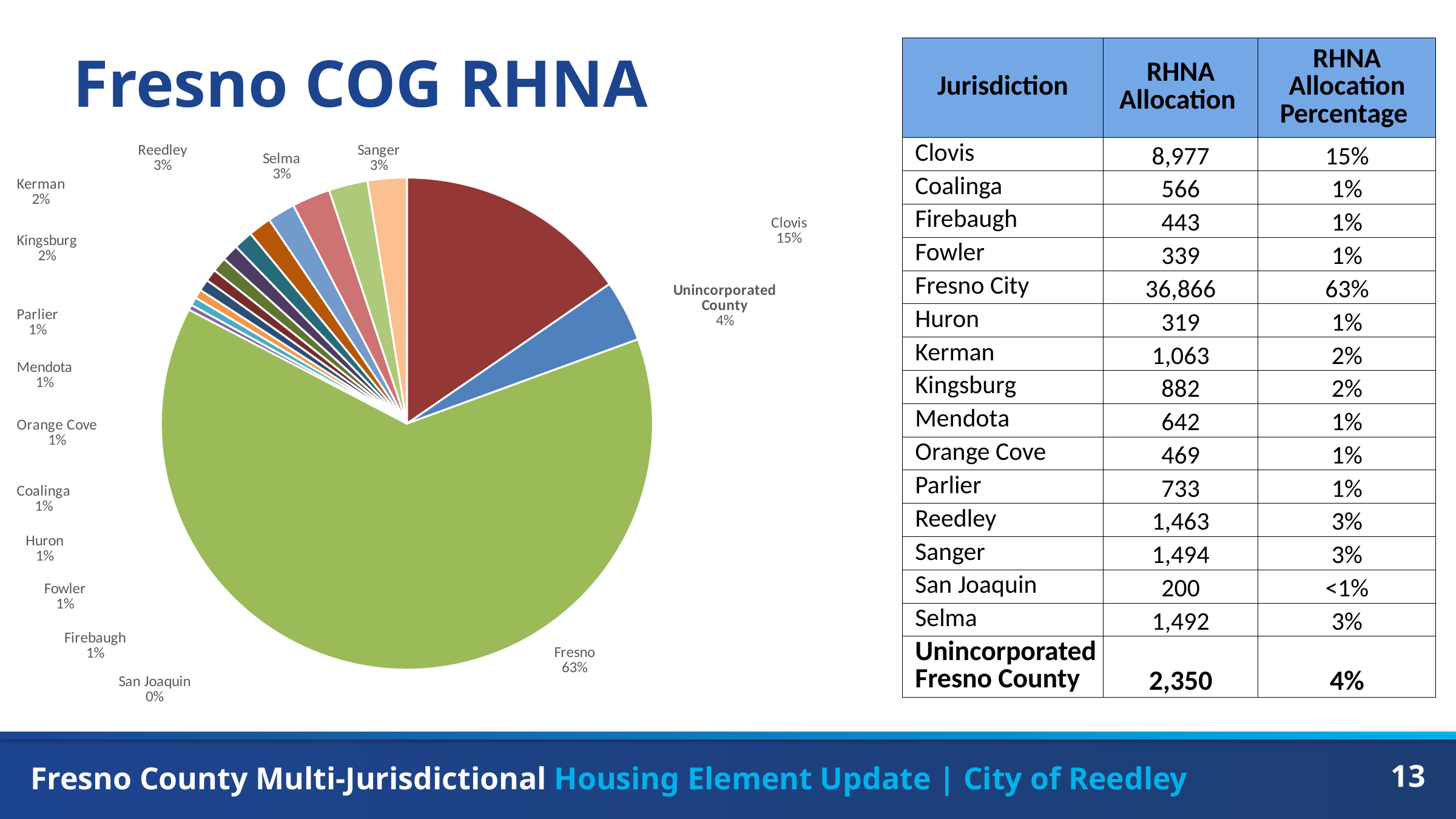
What share of the pie chart does Fresno represent? 63% How many slices does the pie chart have? 16 What is the title of the slide containing the pie chart? Fresno COG RHNA Which slice of the pie chart has the largest share? Fresno What is the difference in percentage points between Fresno and Clovis in the pie chart? 48 What share of the pie chart does Clovis represent? 15% What percentage is shown for Reedley in the pie chart? 3% Which slice of the pie chart has the smallest share? San Joaquin What kind of chart is shown on the slide? pie chart What percentage is shown for Kerman in the pie chart? 2% Which has a larger share in the pie chart, Clovis or Unincorporated County? Clovis What percentage is shown for Unincorporated County in the pie chart? 4%